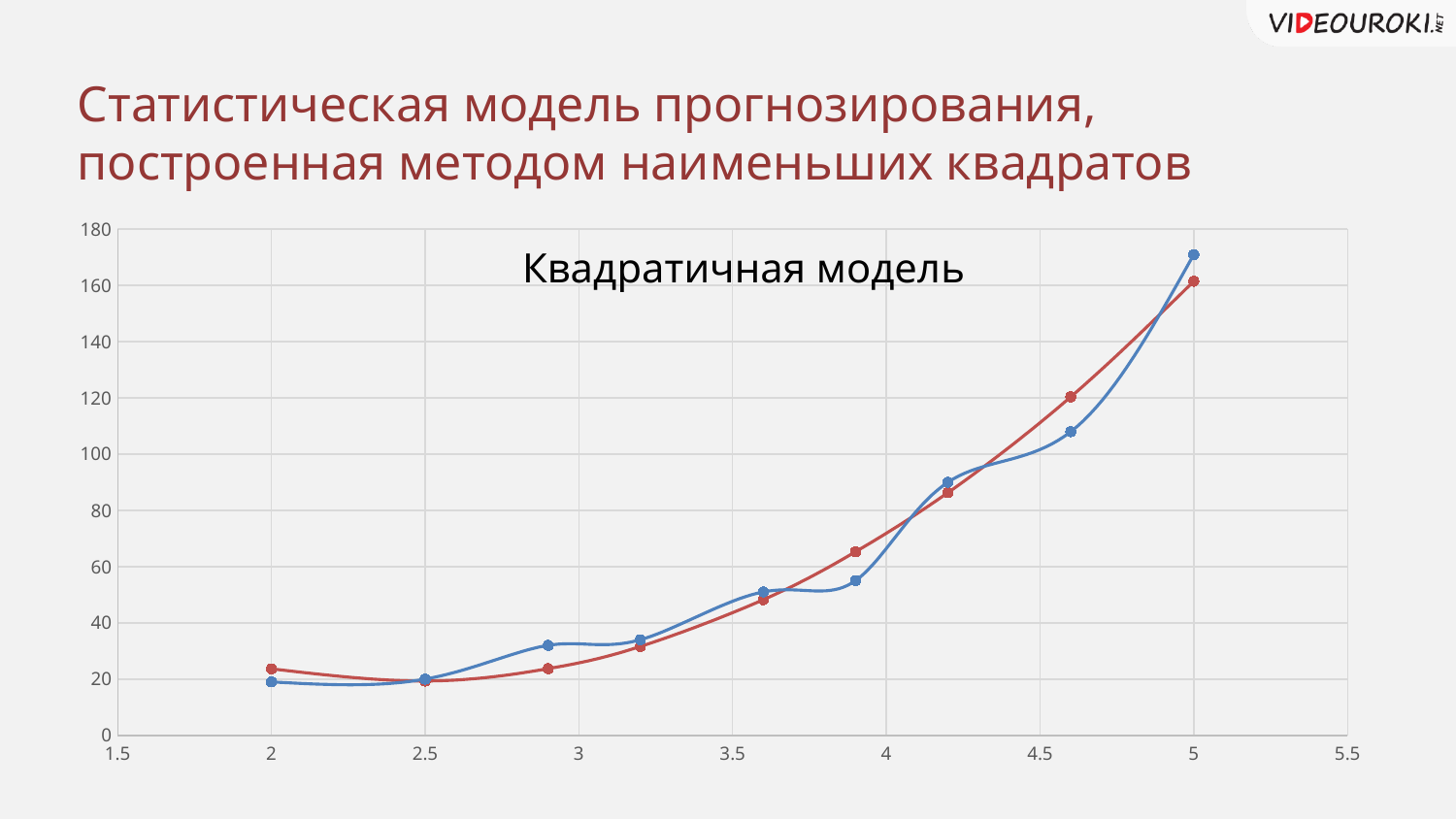
At which x value does the blue series reach its highest point? 5 Is the value of the blue series at x = 5 greater or less than 160? greater How many data points does the blue series have? 9 Is the value of the blue series at x = 2 greater or less than 40? less At x = 4.6, which series has the higher value, blue or red? red Is the value of the red series at x = 4.6 greater or less than 100? greater What kind of chart is shown on the slide? line chart What is the title printed inside the chart area? Квадратичная модель Do the values of the red series generally rise or fall as x increases from 2.5 to 5? rise What two colours are used for the two plotted series? blue and red At x = 5, which series has the higher value, blue or red? blue